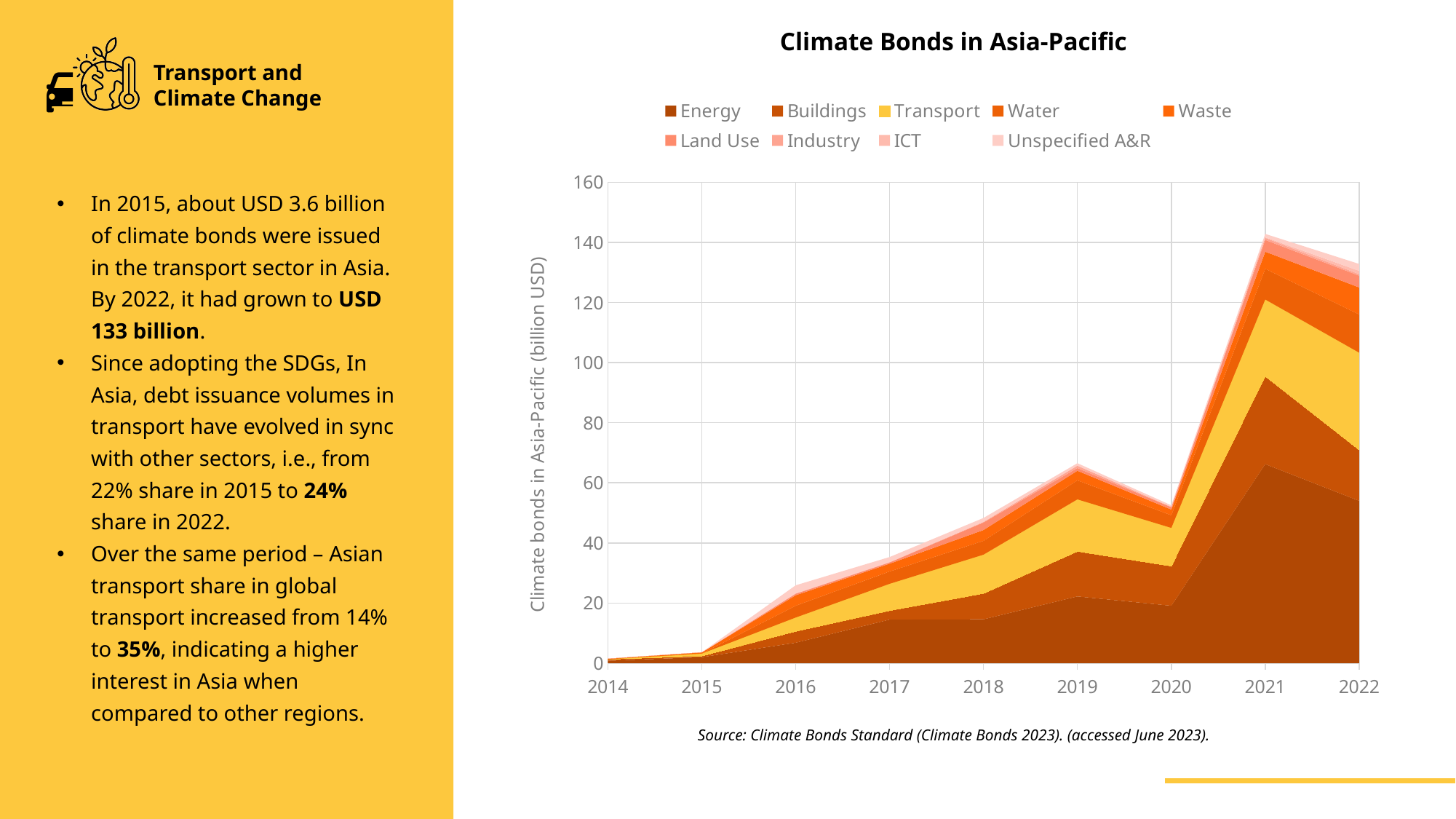
In which year is the total value of climate bonds in Asia-Pacific lowest? 2014 What kind of chart is shown on the slide? Stacked area chart Which year has a larger total of climate bonds, 2019 or 2020? 2019 How many years are shown along the x axis of the chart? 9 What is the title of the chart? Climate Bonds in Asia-Pacific Is the total value of climate bonds in 2016 greater or less than 40 billion USD? less Is the total value of climate bonds in 2021 greater or less than 120 billion USD? greater In which year is the total value of climate bonds in Asia-Pacific highest? 2021 What is the label of the y axis of the chart? Climate bonds in Asia-Pacific (billion USD) Do total climate bond values generally rise or fall from 2014 to 2021? rise Is the total value of climate bonds in 2015 greater or less than 20 billion USD? less How many series does the legend of the Climate Bonds in Asia-Pacific chart list? 9